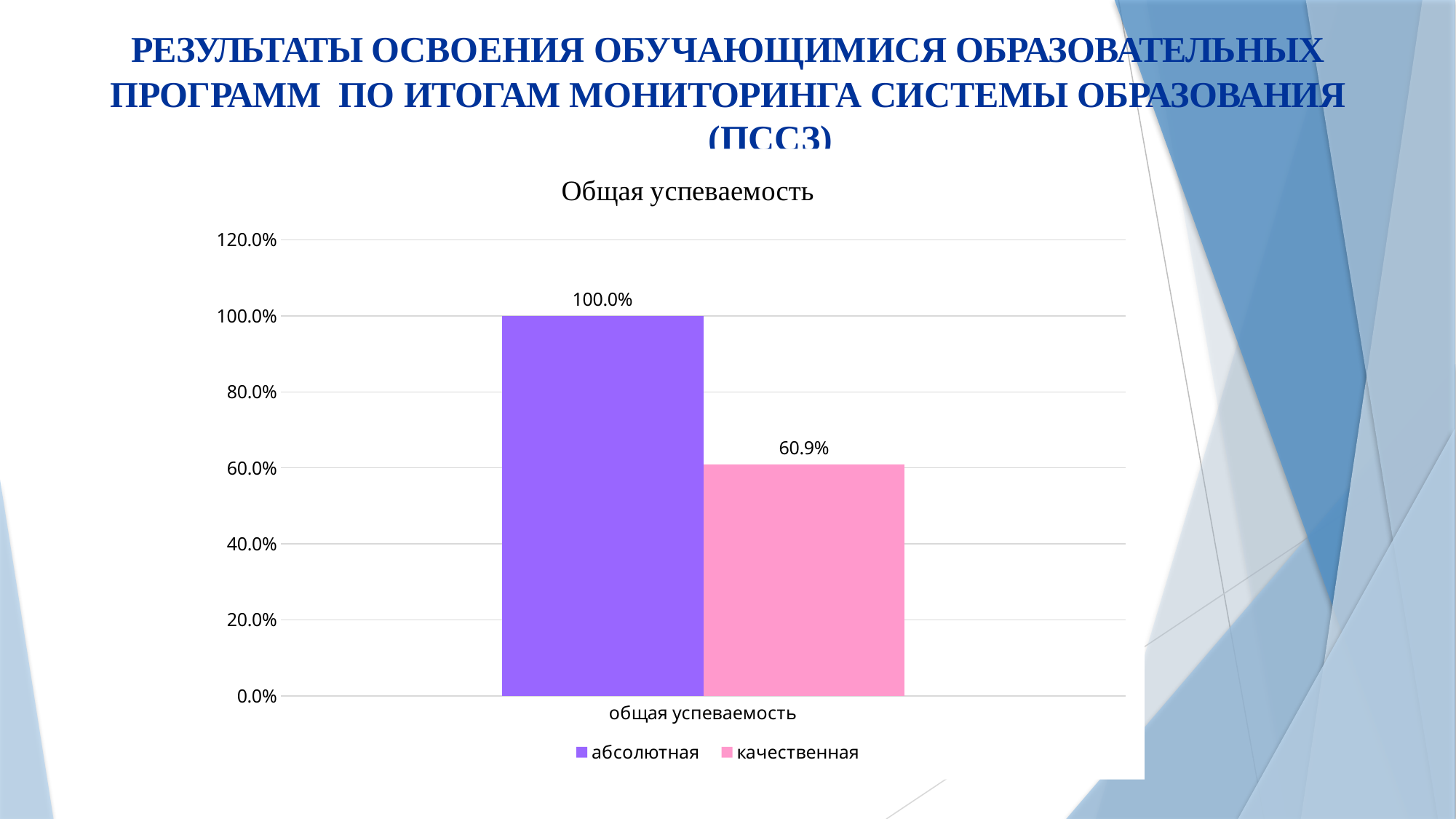
Is the value for качественная greater or less than 80.0%? less How many series does the legend list? 2 How many categories are shown on the x axis? 1 What colour is the bar for the качественная series? pink What is the highest value shown on the y axis? 120.0% Which series has the higher value, абсолютная or качественная? абсолютная What is the title of the chart? Общая успеваемость What kind of chart is shown on the slide? bar chart What is the value of the качественная series in the chart? 60.9% Which series has the lowest value in the chart? качественная What is the difference between the абсолютная and качественная values? 39.1% What is the value of the абсолютная series in the chart? 100.0%